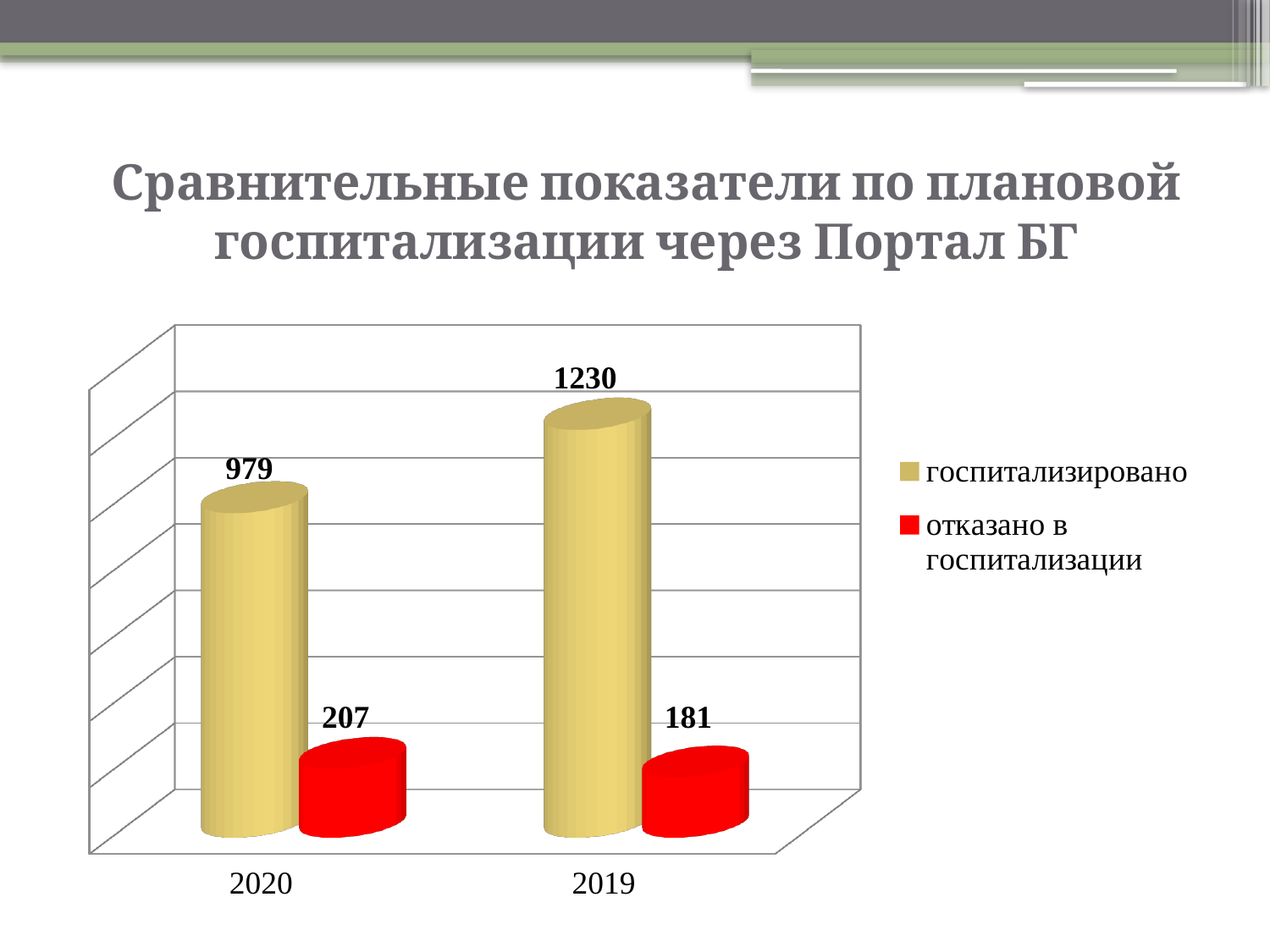
What kind of chart is shown on the slide? bar chart Which year has the higher value for госпитализировано? 2019 Is the value for отказано в госпитализации in 2020 larger or smaller than in 2019? larger What is the value for отказано в госпитализации in 2019? 181 What is the value for отказано в госпитализации in 2020? 207 How many years are shown on the x axis? 2 What is the difference between the отказано в госпитализации values for 2020 and 2019? 26 What is the difference between the госпитализировано values for 2019 and 2020? 251 How many series does the legend list? 2 Which year has the lower value for отказано в госпитализации? 2019 What is the value for госпитализировано in 2019? 1230 What is the value for госпитализировано in 2020? 979